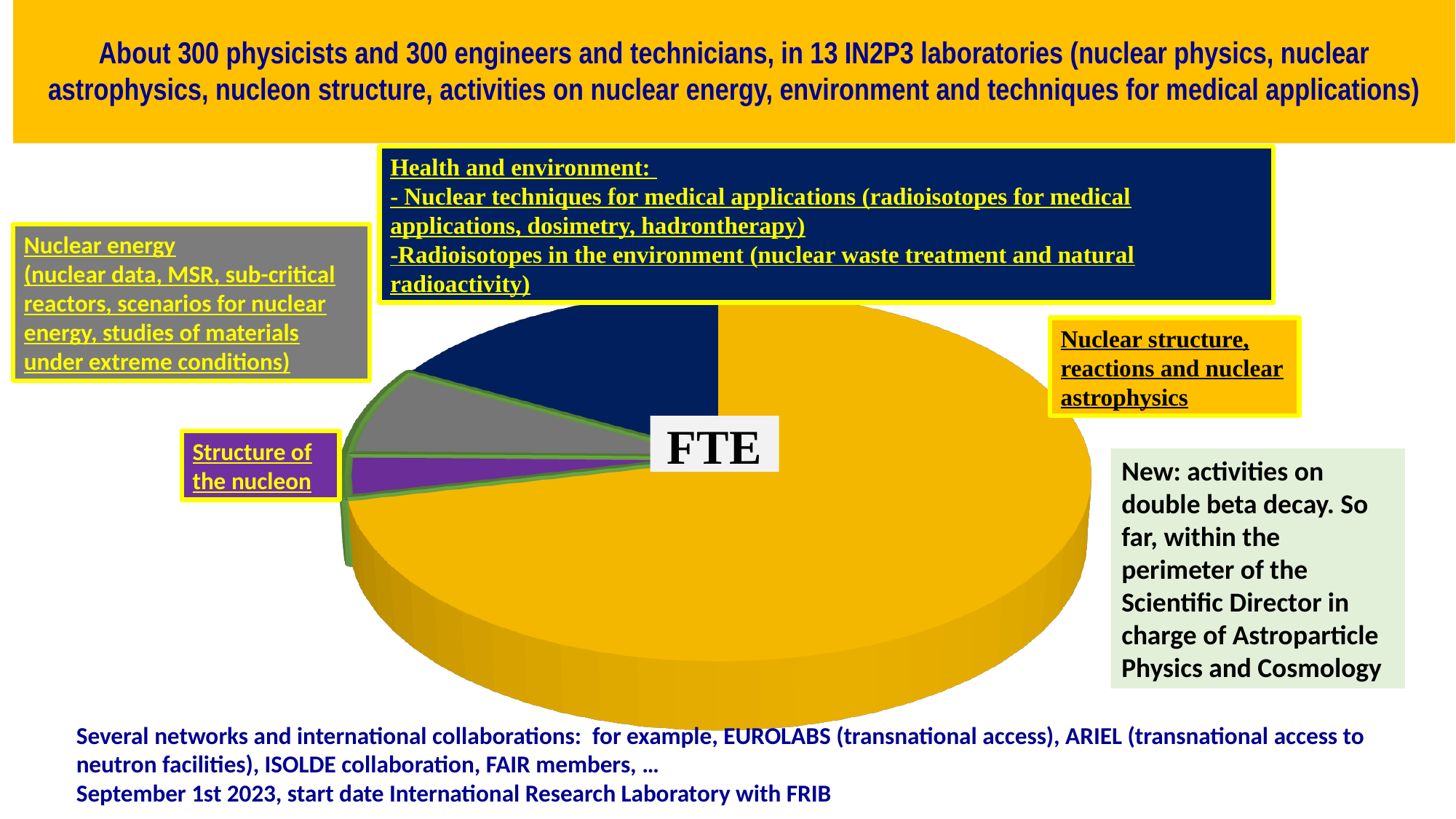
Which slice is larger: Nuclear structure, reactions and nuclear astrophysics or Health and environment? Nuclear structure, reactions and nuclear astrophysics Which slice is larger: Health and environment or Structure of the nucleon? Health and environment What kind of chart is shown on the slide? Pie chart Which slice is larger: Nuclear energy or Structure of the nucleon? Nuclear energy What colour is the slice for Nuclear structure, reactions and nuclear astrophysics? Yellow What is the title shown at the centre of the pie chart? FTE Which category has the largest slice of the pie chart? Nuclear structure, reactions and nuclear astrophysics